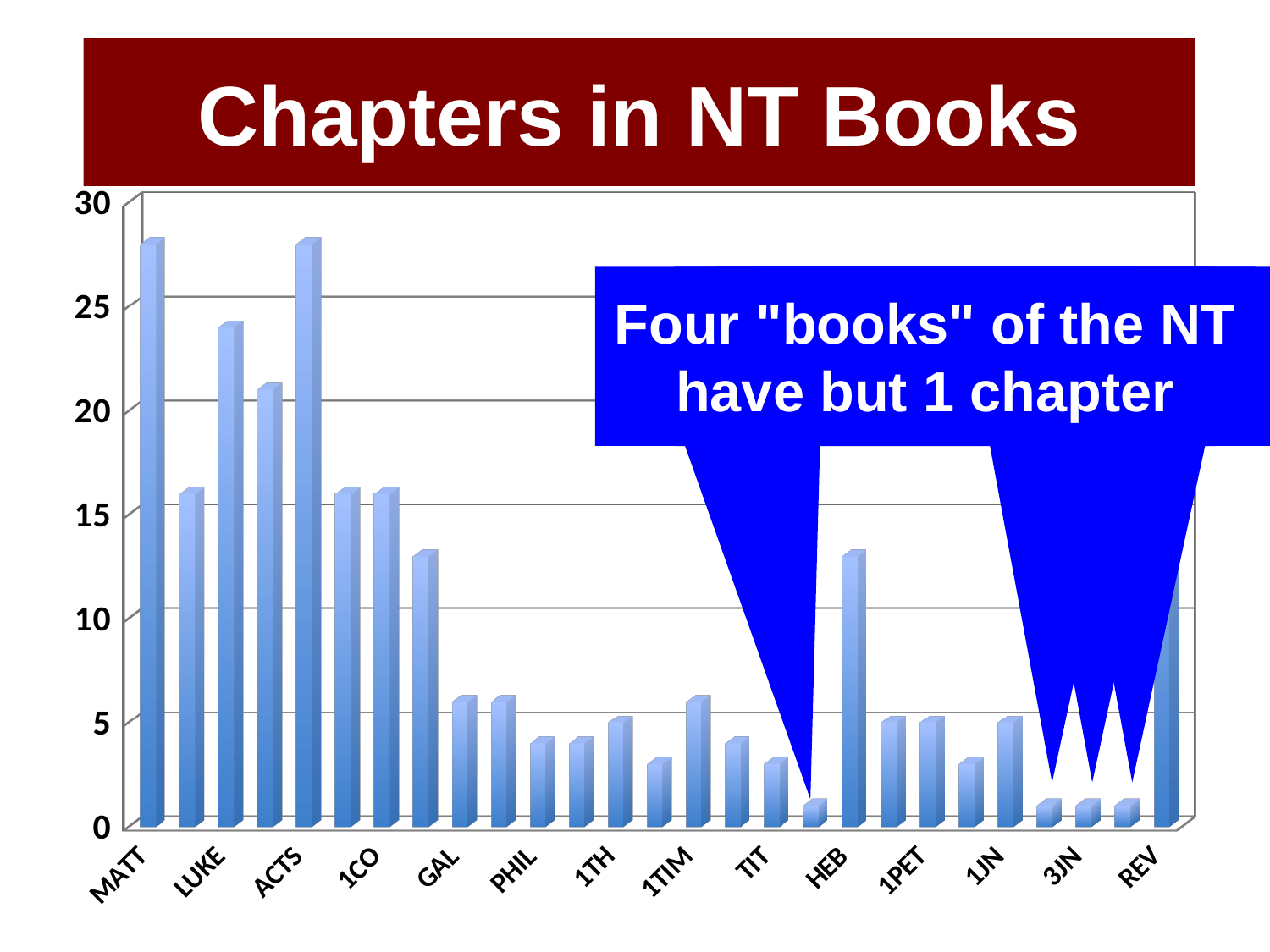
Which has the larger value, GAL or REV? REV According to the callout on the chart, how many NT books have only 1 chapter? Four Is the value for LUKE greater or less than 20? greater Is the value for HEB greater or less than 10? greater Which has the larger value, LUKE or HEB? LUKE What is the title of the chart? Chapters in NT Books Is the value for TIT greater or less than 5? less How many bars are plotted in the chart? 27 What kind of chart is shown on the slide? bar chart